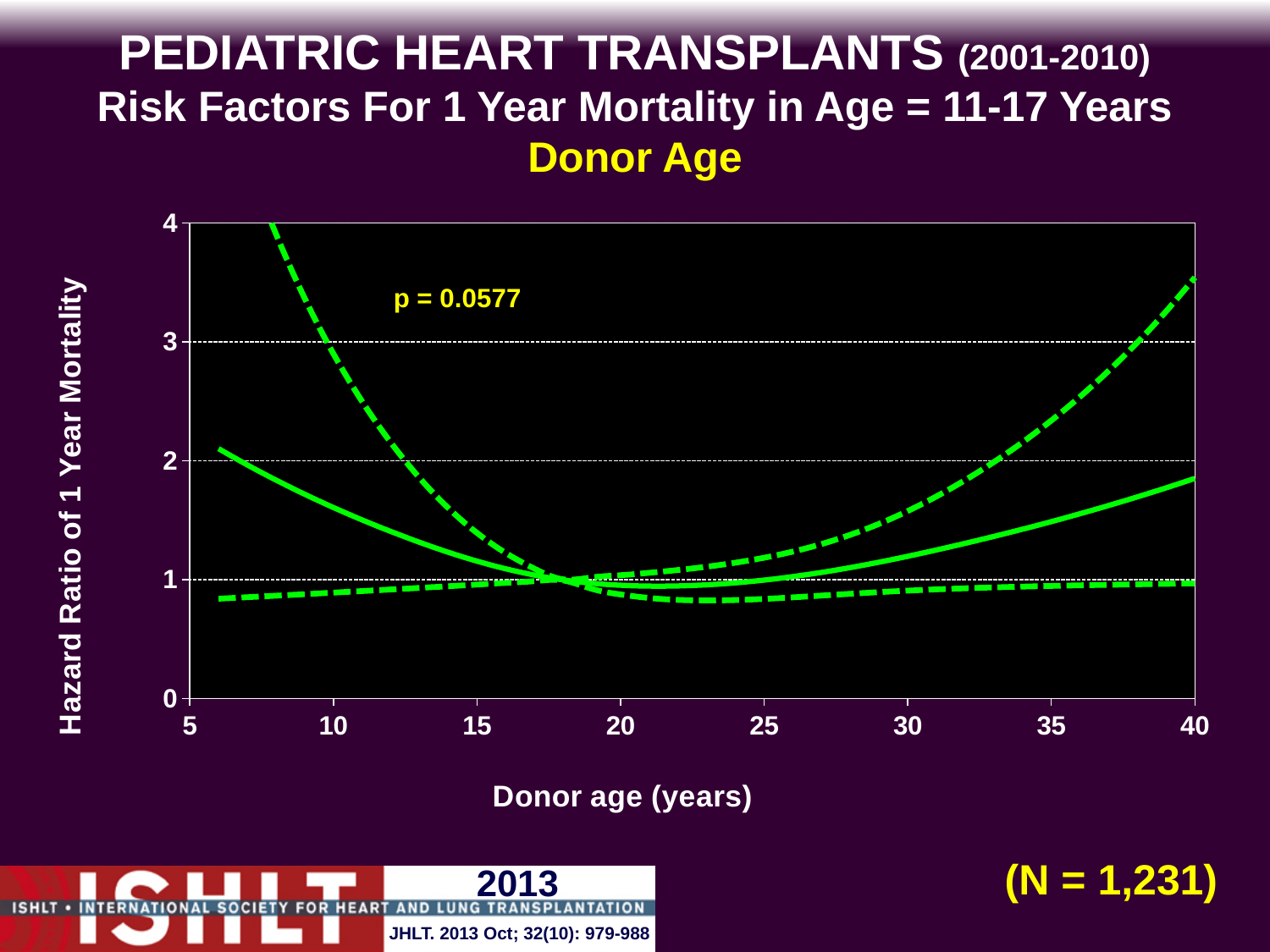
How many lines are plotted on the chart? 3 Does the solid line rise or fall as donor age increases from 30 to 40 years? rise What sample size (N) is shown on the slide? N = 1,231 What kind of chart is shown on the slide? line chart What is the label of the x axis? Donor age (years) Does the solid line rise or fall as donor age increases from 5 to 15 years? fall Is the value of the upper dashed line at donor age 35 greater or less than 2? greater Is the value of the solid line at donor age 40 greater or less than 2? less Is the value of the solid line at donor age 10 greater or less than 1? greater What is the label of the y axis? Hazard Ratio of 1 Year Mortality What p-value is printed on the chart? p = 0.0577